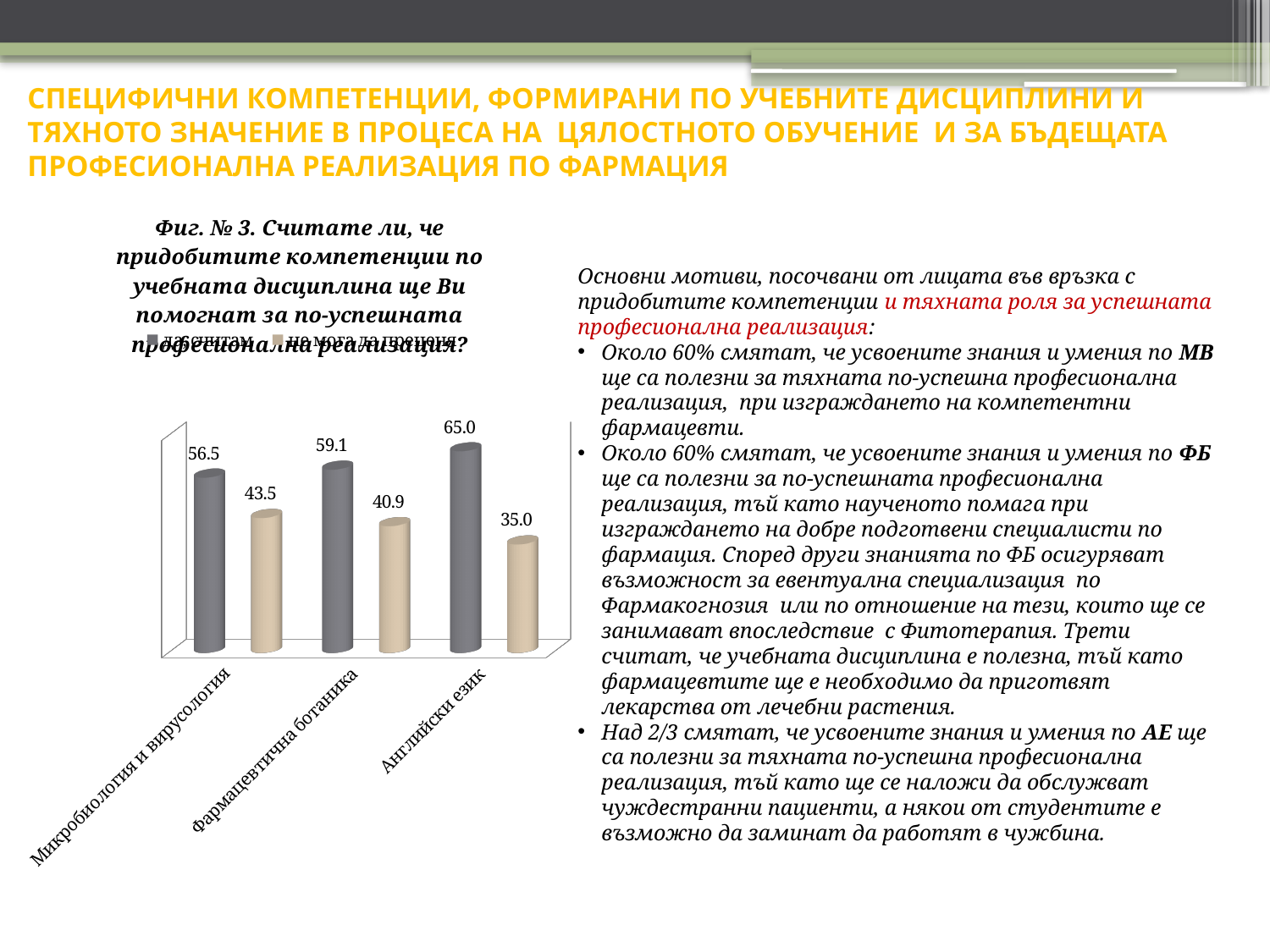
Which category has the highest dark grey bar? Английски език How many categories are shown on the x axis of the chart? 3 Which category has the lowest beige bar? Английски език What is the value of the dark grey bar for Микробиология и вирусология? 56.5 What is the value of the beige bar for Фармацевтична ботаника? 40.9 What is the value of the beige bar for Английски език? 35.0 Which is larger for Фармацевтична ботаника: the dark grey bar or the beige bar? the dark grey bar What is the difference between the dark grey and beige bars for Микробиология и вирусология? 13.0 What kind of chart is shown on the slide? bar chart How many series does the chart plot? 2 Do the dark grey bars rise or fall from Микробиология и вирусология to Английски език? rise What is the value of the dark grey bar for Английски език? 65.0